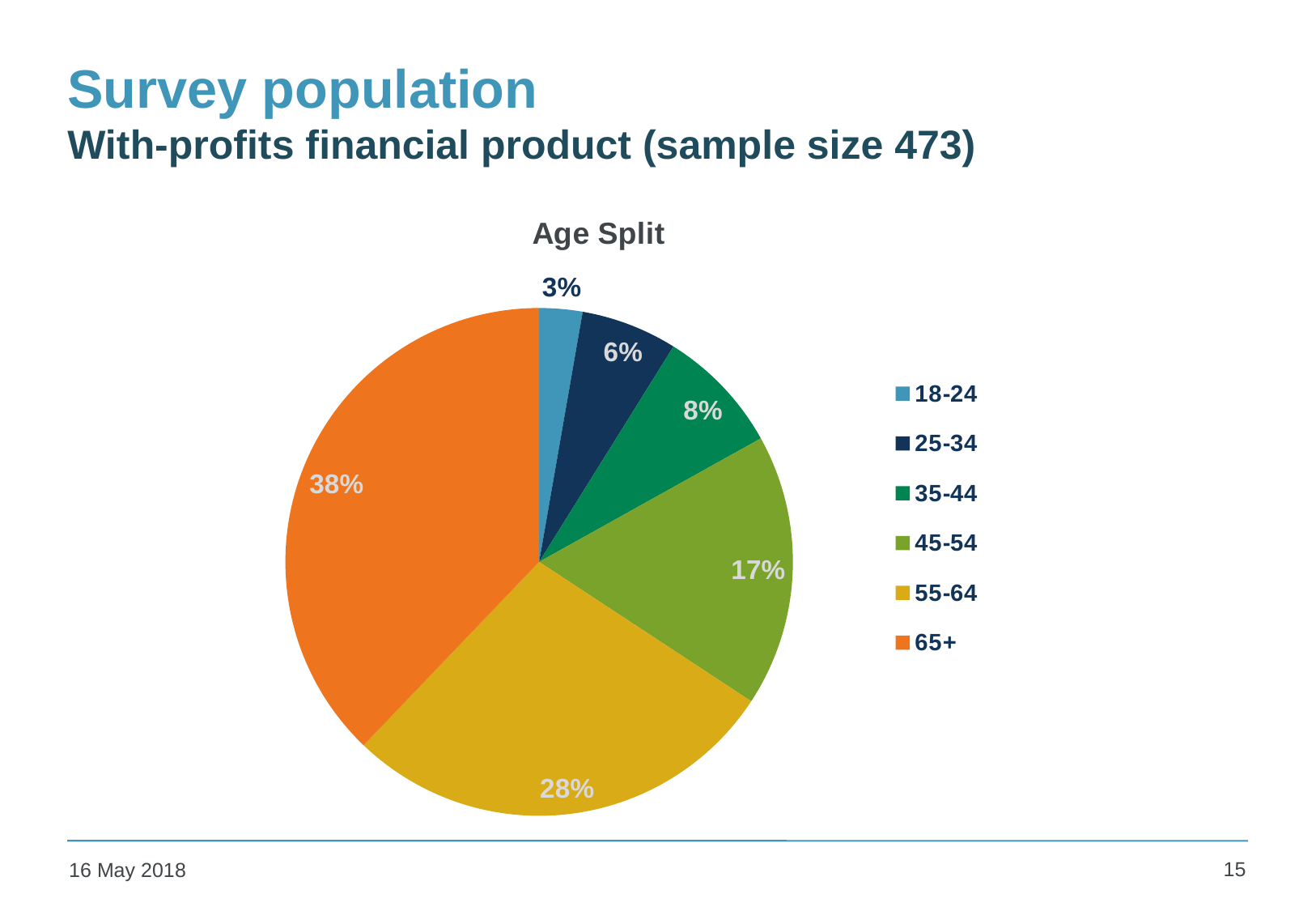
What share of the survey population is aged 18-24? 3% What share of the survey population is aged 65+? 38% What kind of chart is shown on the slide? pie chart Which age group has the smallest share of the pie? 18-24 How many age groups does the legend list? 6 What share of the survey population is aged 35-44? 8% What is the difference in percentage points between the 65+ and 55-64 shares? 10 What is the title of the chart? Age Split What colour is the slice for the 55-64 age group? yellow Which age group has the largest share of the pie? 65+ Which is larger, the share for 45-54 or the share for 25-34? 45-54 What share of the survey population is aged 55-64? 28%